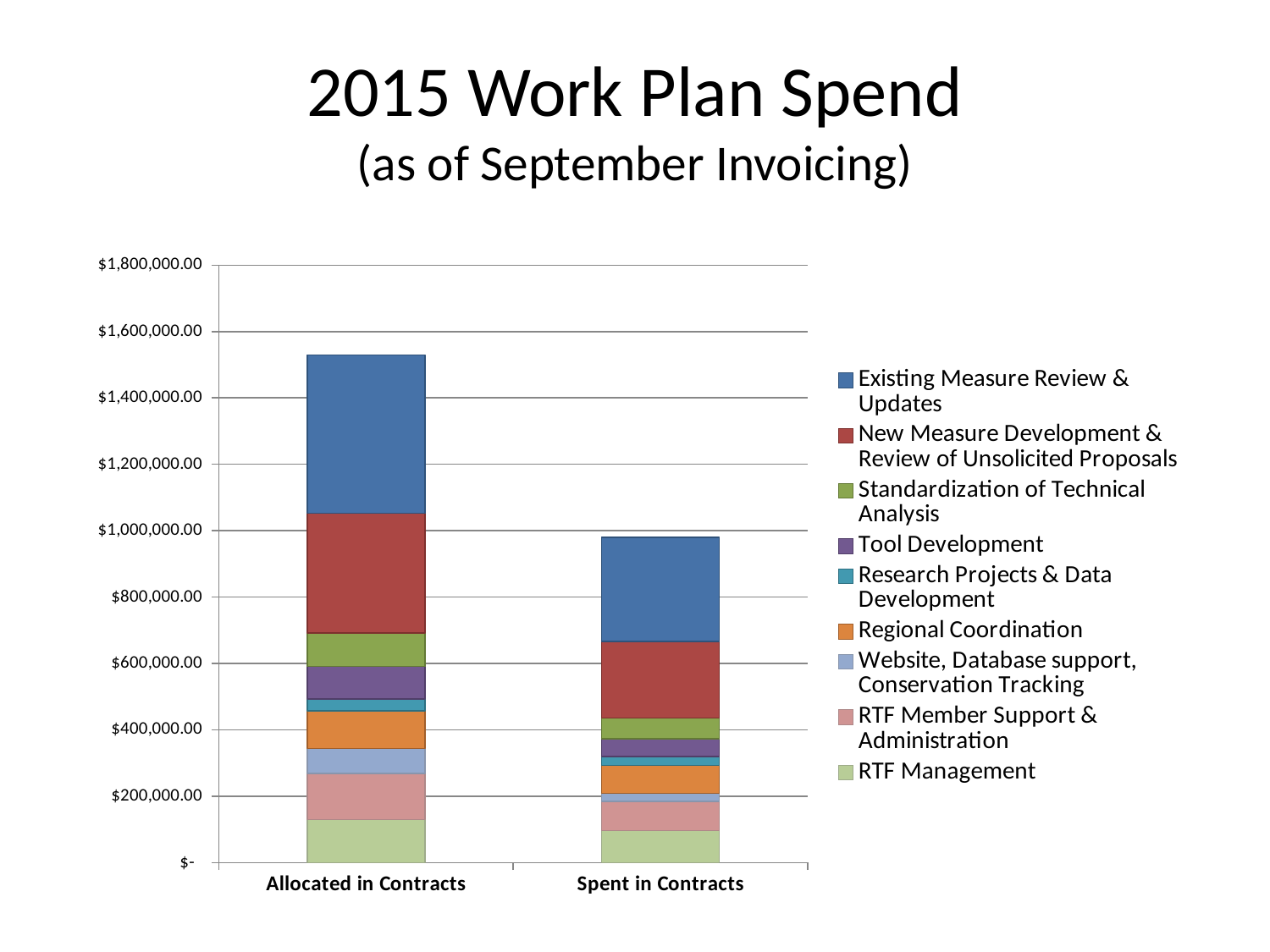
What is the title of the chart slide? 2015 Work Plan Spend (as of September Invoicing) What kind of chart is shown on the slide? Stacked bar chart What is the highest value labelled on the y axis? $1,800,000.00 Which category has the lowest total bar height? Spent in Contracts Is the total for Allocated in Contracts greater or less than $1,400,000.00? greater How many categories are shown on the x axis? 2 Which series is listed first in the legend? Existing Measure Review & Updates Is the total for Allocated in Contracts greater or less than $1,600,000.00? less Is the total for Spent in Contracts greater or less than $1,200,000.00? less How many series does the legend list? 9 Which bar is taller, Allocated in Contracts or Spent in Contracts? Allocated in Contracts